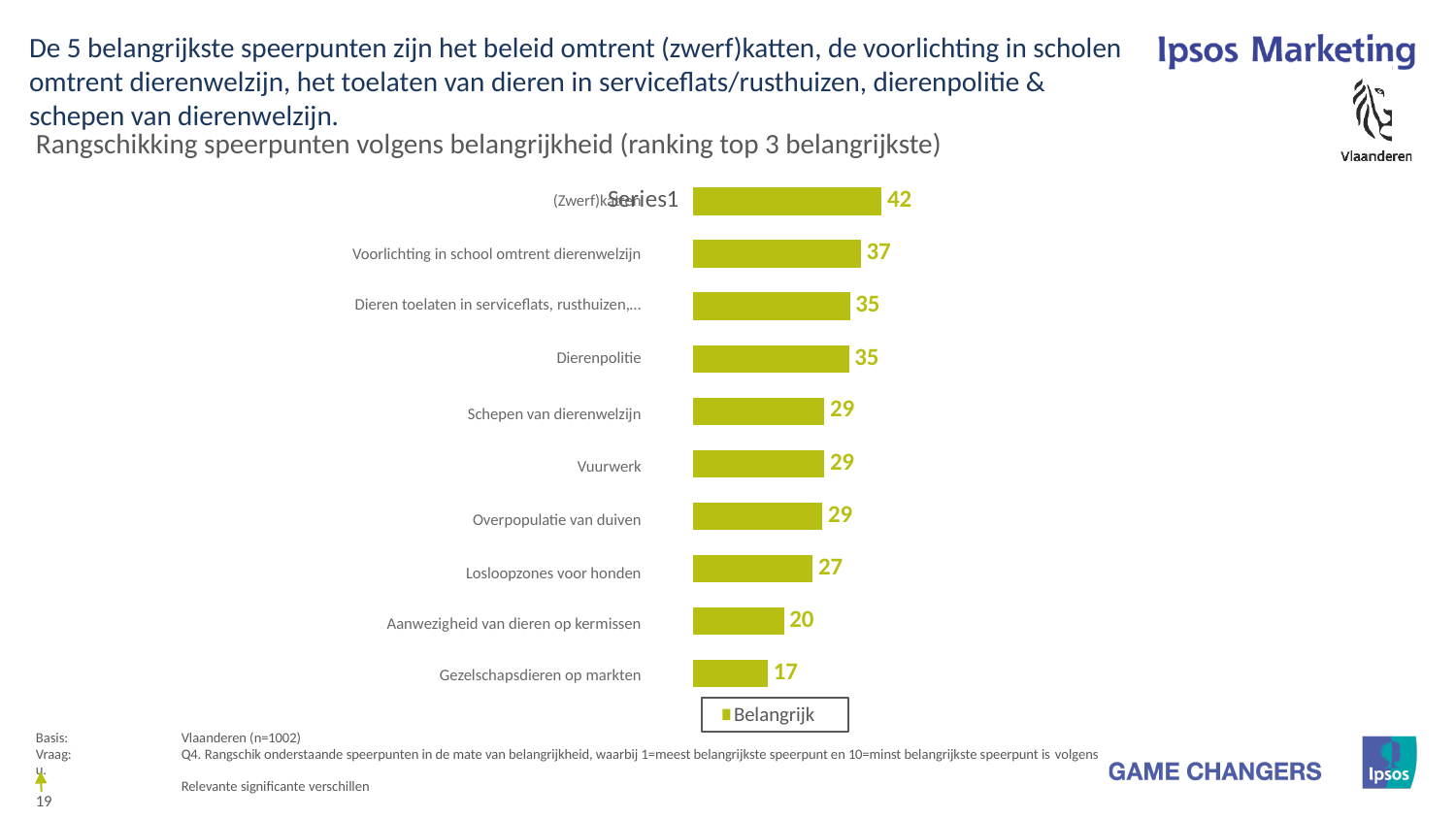
What is the legend entry shown below the chart? Belangrijk What is the value for Voorlichting in school omtrent dierenwelzijn? 37 Which category has the lowest value? Gezelschapsdieren op markten What is the highest value shown in the chart? 42 What is the value for Losloopzones voor honden? 27 How many categories are shown in the chart? 10 What is the subtitle of the chart? Rangschikking speerpunten volgens belangrijkheid (ranking top 3 belangrijkste) What is the difference between the values for Voorlichting in school omtrent dierenwelzijn and Gezelschapsdieren op markten? 20 Which is larger: the value for Schepen van dierenwelzijn or the value for Losloopzones voor honden? Schepen van dierenwelzijn What kind of chart is shown on the slide? Bar chart What is the value for Dierenpolitie? 35 What is the value for Aanwezigheid van dieren op kermissen? 20